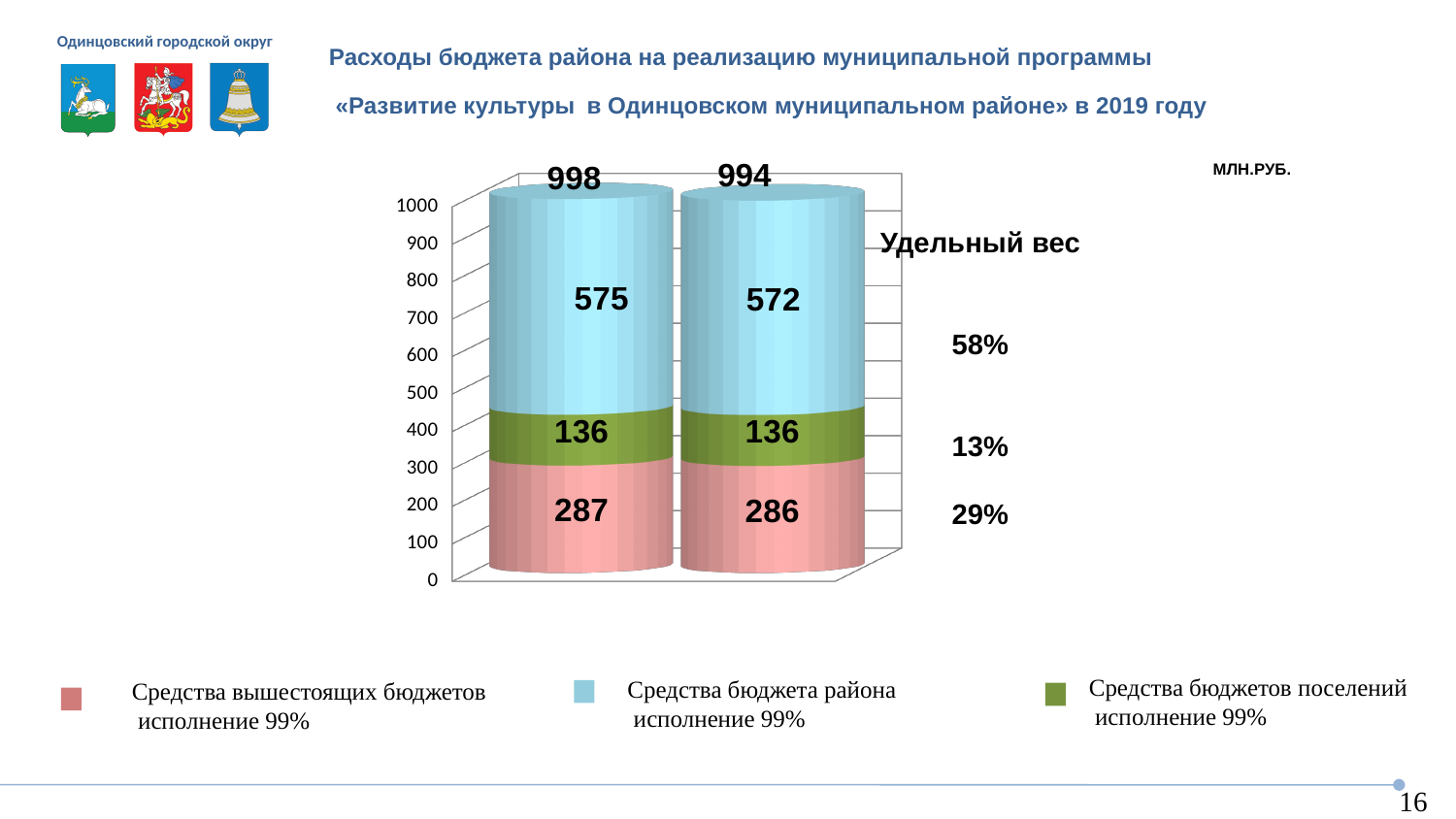
What is the total of the right stacked bar? 994 What is the total of the left stacked bar? 998 What is the value of Средства бюджета района in the left bar? 575 What is the value of Средства бюджетов поселений in the right bar? 136 Which series has the largest value in the left bar? Средства бюджета района What is the difference between the totals of the left bar and the right bar? 4 Which series has the smallest value in the right bar? Средства бюджетов поселений What share (Удельный вес) is shown for Средства бюджета района? 58% What is the difference between Средства бюджета района in the left bar and in the right bar? 3 What is the value of Средства вышестоящих бюджетов in the right bar? 286 How many series does the legend list? 3 How many stacked bars are plotted in the chart? 2